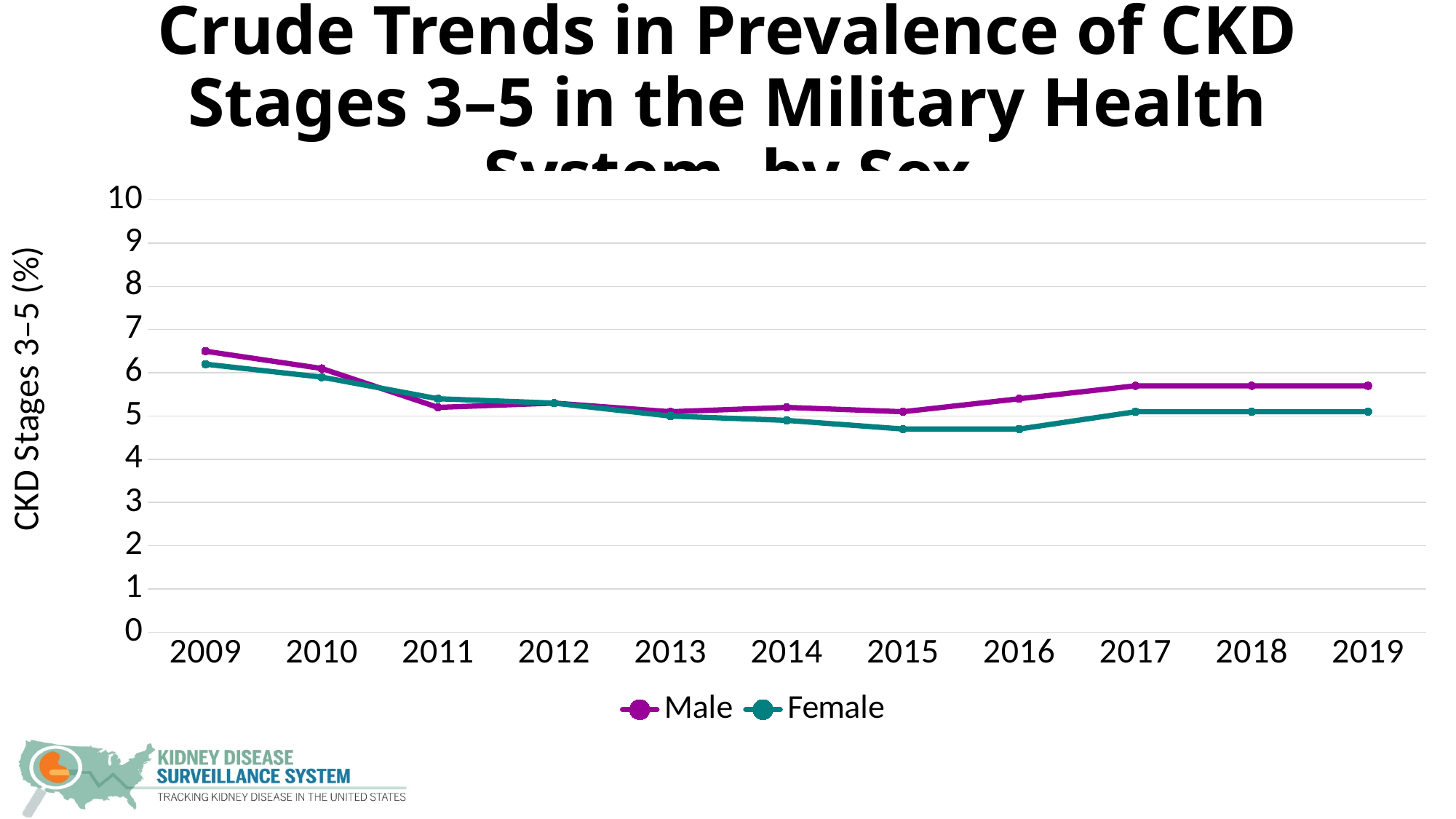
In 2019, which series has the larger value, Male or Female? Male How many series does the legend list? 2 What kind of chart is shown on the slide? Line chart Does the Male series rise or fall from 2009 to 2011? Fall In which year is the Female series at its highest? 2009 Is the Female value for 2015 greater or less than 5? less Is the Male value for 2009 greater or less than 6? greater In which year is the Male series at its highest? 2009 What is the label on the y axis? CKD Stages 3–5 (%) Is the Male value for 2018 greater or less than 5? greater How many years are plotted along the x axis? 11